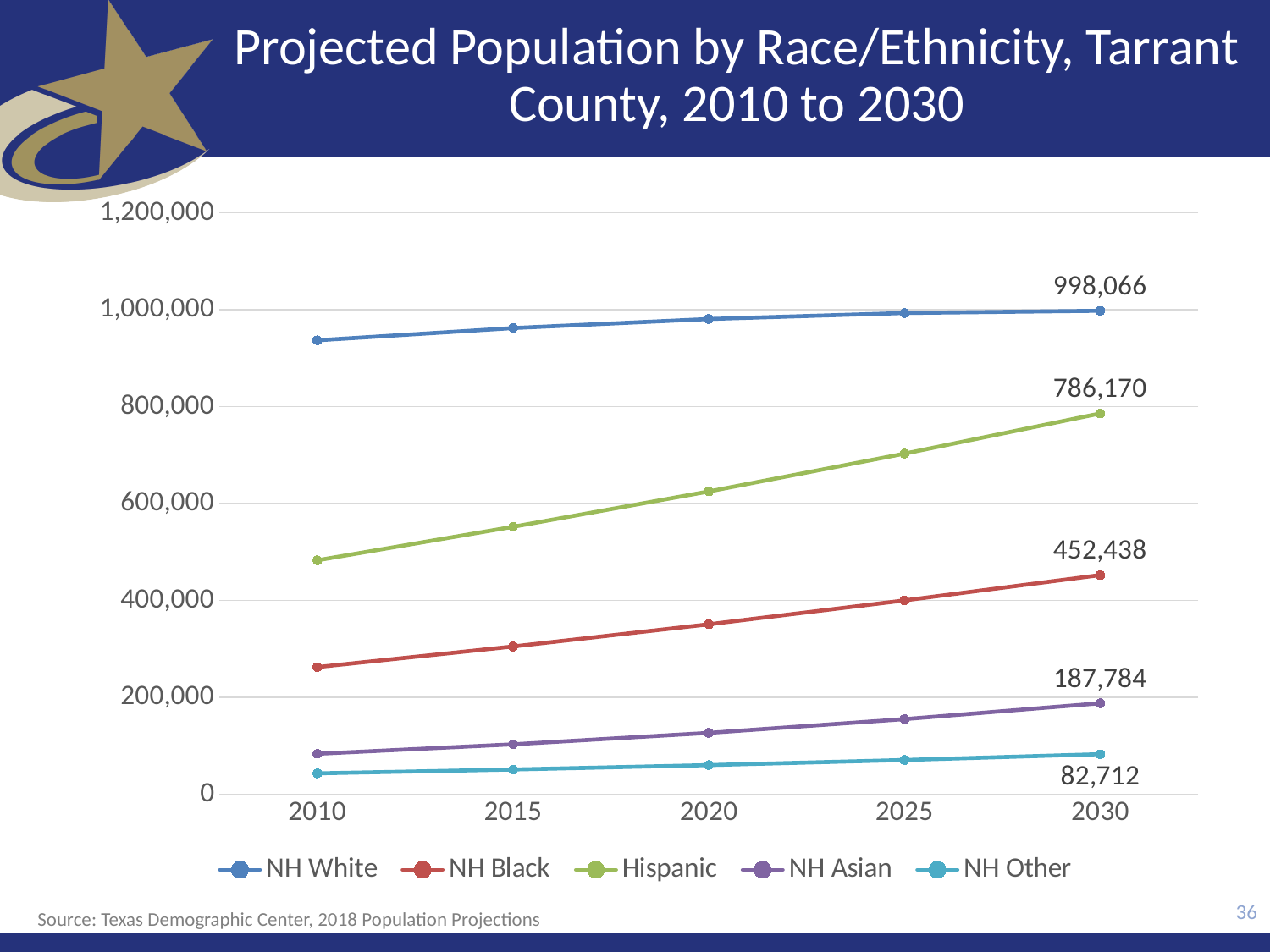
What is the difference between the projected NH White and Hispanic populations in 2030? 211,896 What is the projected NH Other population in 2030? 82,712 How many series does the legend list? 5 Is the NH White population in 2010 greater or less than 800,000? greater What is the projected NH Black population in 2030? 452,438 In 2030, which is larger: the projected NH Asian population or the projected NH Other population? NH Asian Does the Hispanic population rise or fall from 2010 to 2030? Rise Which race/ethnicity group has the lowest projected population in 2030? NH Other What kind of chart is shown on the slide? Line chart What is the projected NH White population in 2030? 998,066 What is the projected Hispanic population in 2030? 786,170 Which race/ethnicity group has the highest projected population in 2030? NH White